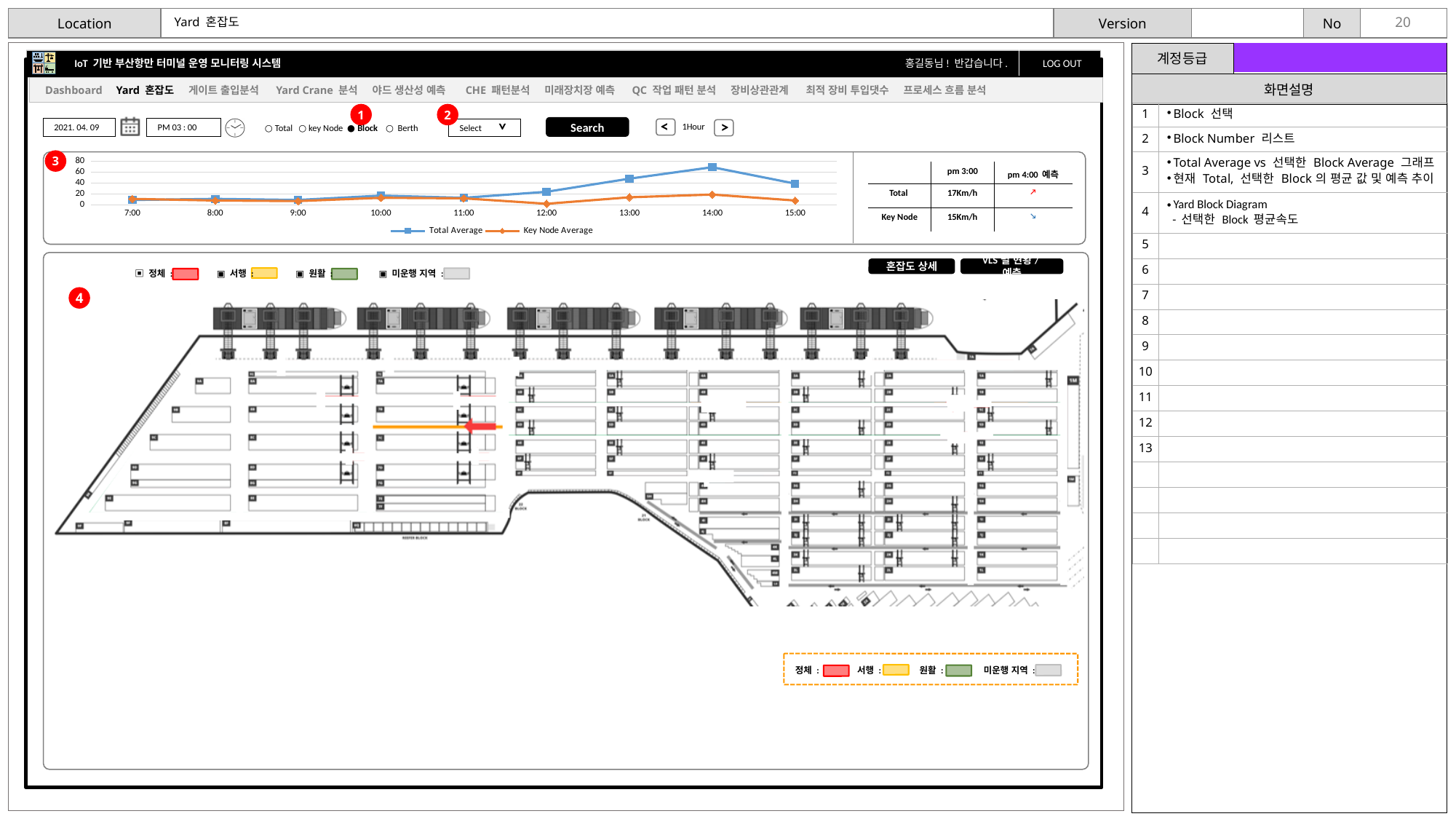
Is the Total Average value at 14:00 greater or less than 60? greater Is the Total Average value at 7:00 greater or less than 20? less At 12:00, which series has the larger value, Total Average or Key Node Average? Total Average How many series does the legend of the line chart list? 2 Does the Total Average series rise or fall between 11:00 and 14:00? rise What kind of chart is shown at the top of the slide? line chart Is the Key Node Average value at 14:00 greater or less than 40? less At which time does the Total Average series reach its highest value? 14:00 At 14:00, which series has the larger value, Total Average or Key Node Average? Total Average Which colour is used for the Key Node Average series in the line chart? orange How many time points are plotted along the x axis of the line chart? 9 What are the two series named in the line chart's legend? Total Average and Key Node Average